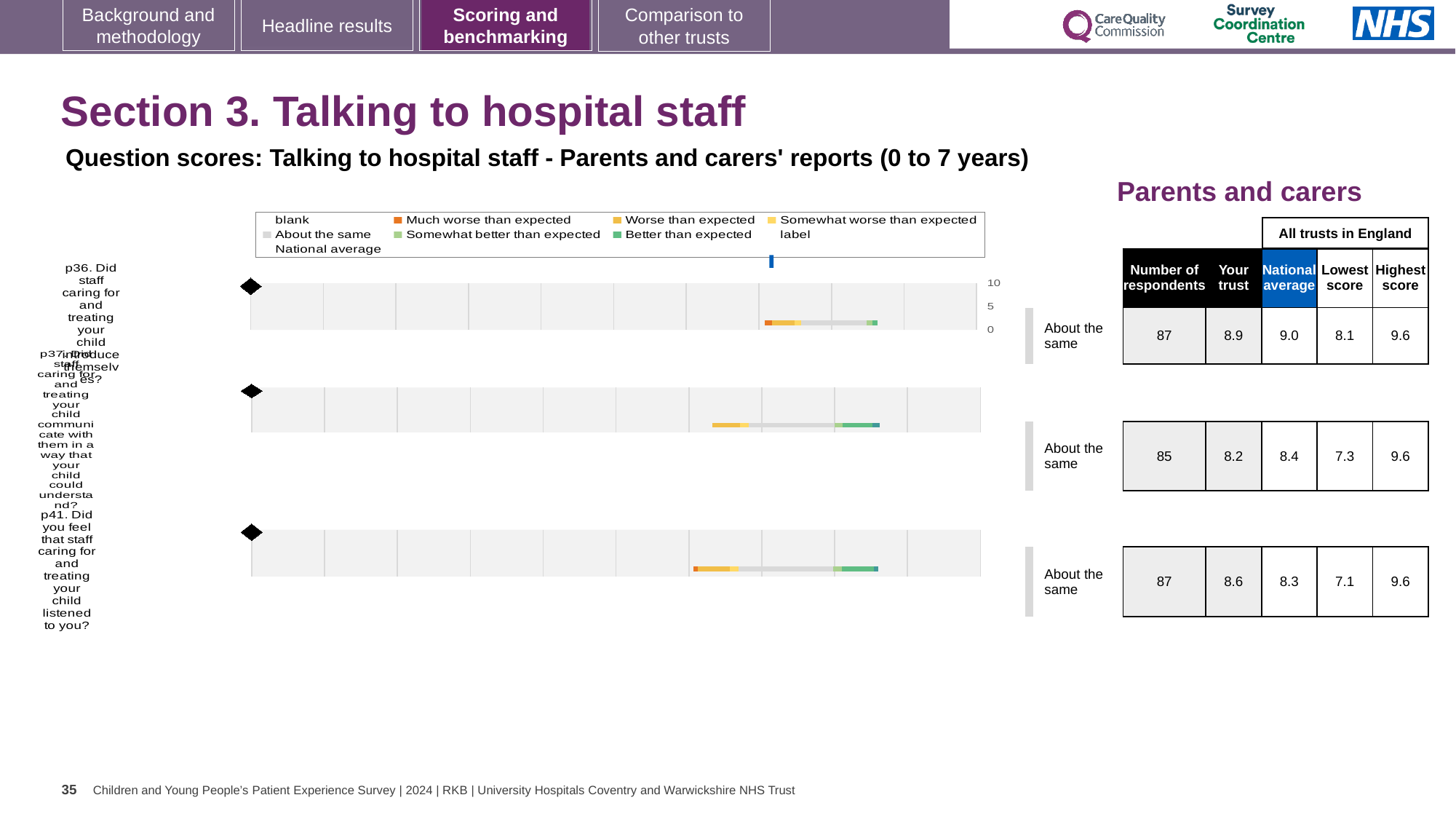
What kind of chart is used to show the question scores on this slide? bar chart Which question has the lowest Lowest score across all trusts in England? p41 For question p36 (Did staff caring for and treating your child introduce themselves?), what is the Your trust score? 8.9 For question p41, which is larger: the Your trust score or the National average? Your trust For question p41 (Did you feel that staff listened to you?), what is the Highest score among all trusts in England? 9.6 How many questions (charts) are shown in the Talking to hospital staff section on this slide? 3 Which question has the highest Your trust score? p36 What benchmark category is shown for all three questions on this slide? About the same How many respondents answered question p37? 85 What is the maximum value shown on the score axis of the charts? 10 For question p37 (Did staff communicate with your child in a way they could understand?), what is the National average score? 8.4 For question p36, what is the difference between the Highest score and the Lowest score? 1.5